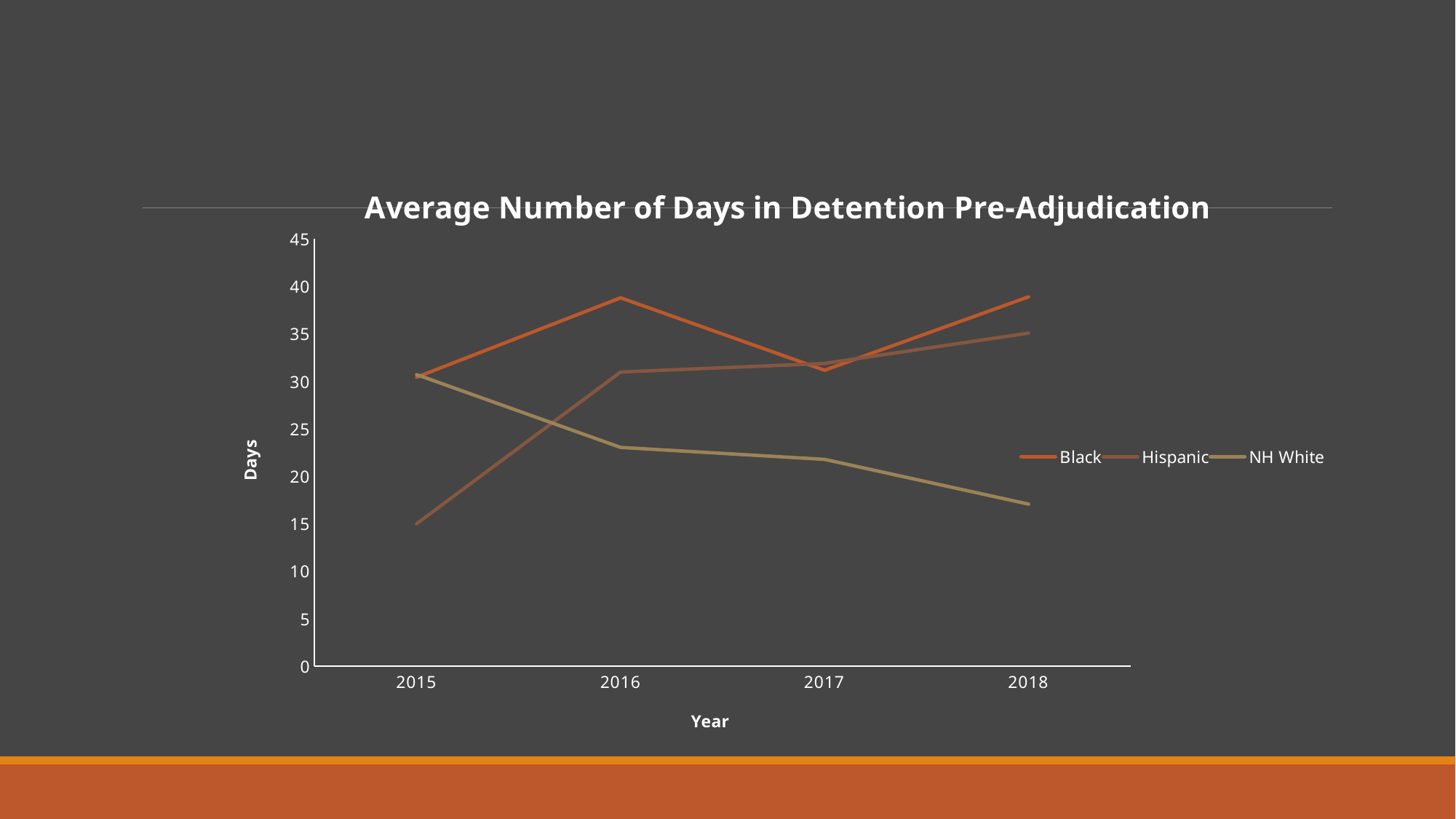
Is the value for Black in 2016 greater or less than 35? greater In 2015, which is larger: the value for Black or the value for Hispanic? Black How many years are shown on the x axis? 4 Is the value for Hispanic in 2015 greater or less than 20? less What kind of chart is shown on the slide? line chart Is the value for NH White in 2018 greater or less than 20? less Does the NH White line rise or fall from 2015 to 2018? fall Which series has the lowest value in 2018? NH White What is the title of the chart? Average Number of Days in Detention Pre-Adjudication How many series does the legend list? 3 Does the Hispanic line rise or fall from 2015 to 2018? rise Which series has the highest value in 2016? Black